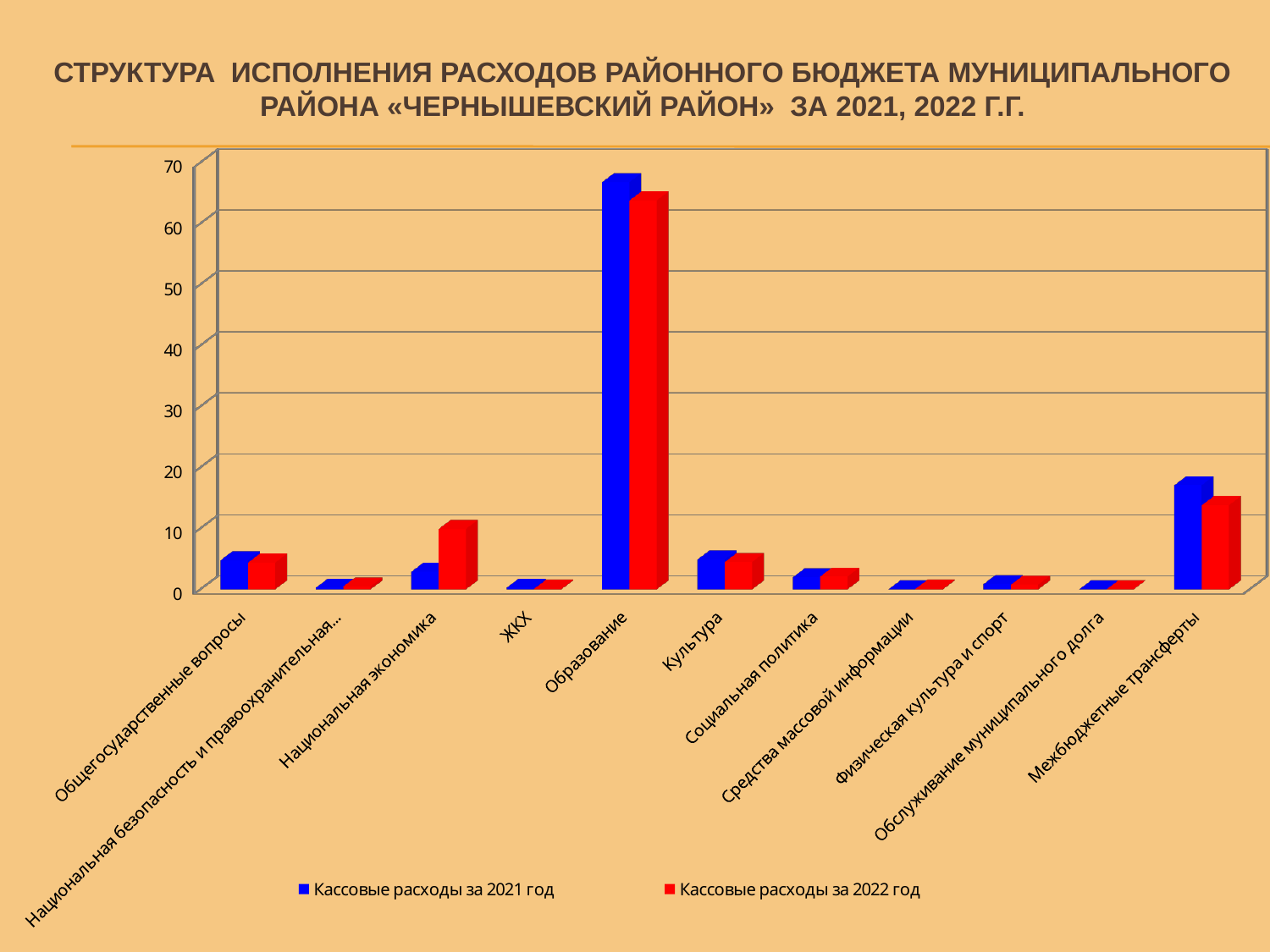
Is the value for Национальная экономика in Кассовые расходы за 2022 год greater or less than 20? less Which category has the highest value for Кассовые расходы за 2021 год? Образование For Национальная экономика, which series has the larger value: Кассовые расходы за 2021 год or Кассовые расходы за 2022 год? Кассовые расходы за 2022 год Is the value for Межбюджетные трансферты in Кассовые расходы за 2021 год greater or less than 10? greater Is the value for Образование in Кассовые расходы за 2021 год greater or less than 60? greater What kind of chart is shown on the slide? bar chart Which category has the highest value for Кассовые расходы за 2022 год? Образование How many categories are shown on the x axis? 11 How many series does the legend list? 2 For Межбюджетные трансферты, which series has the larger value: Кассовые расходы за 2021 год or Кассовые расходы за 2022 год? Кассовые расходы за 2021 год Which colour represents Кассовые расходы за 2022 год in the legend? red